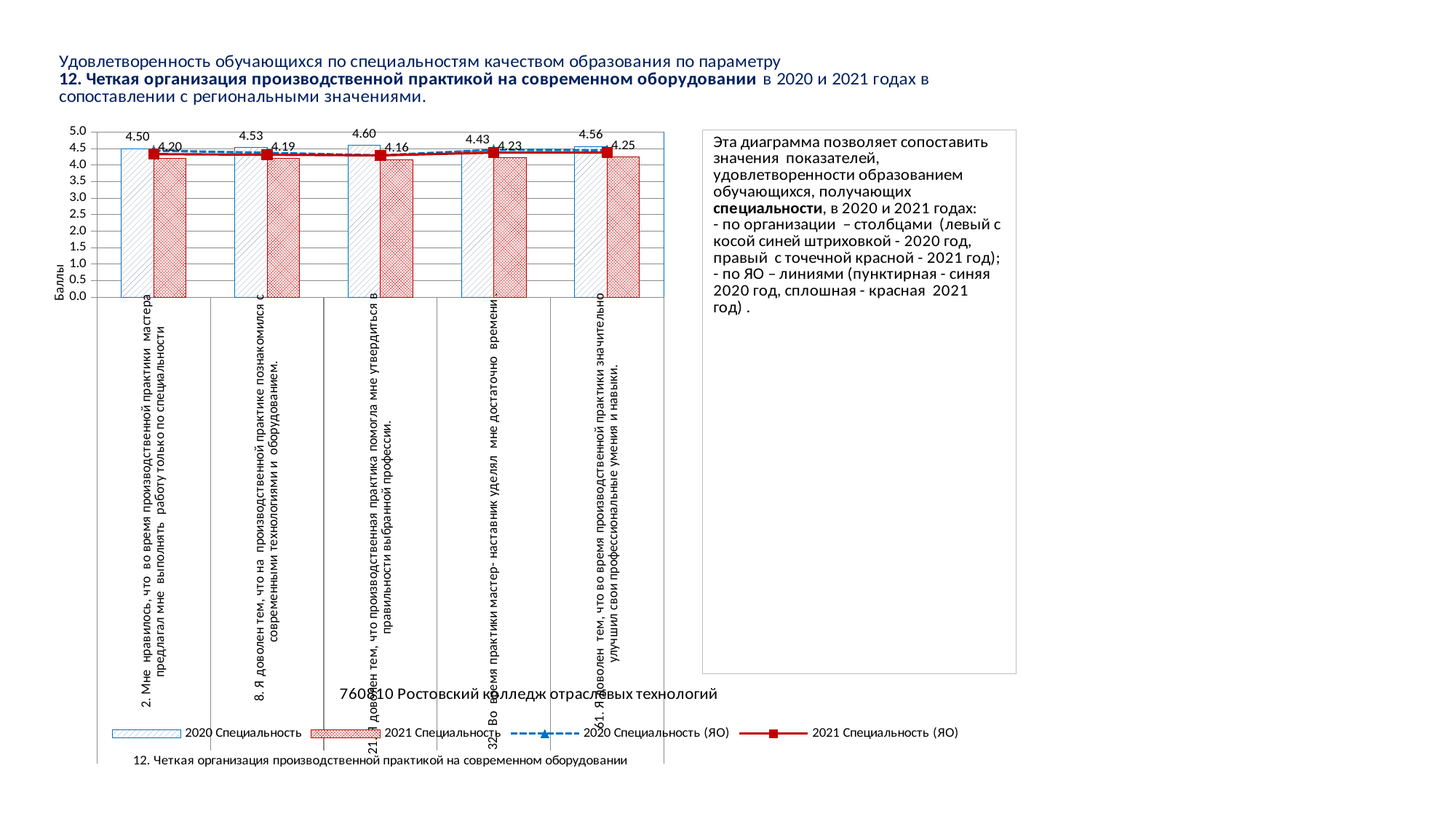
Which category has the highest 2020 Специальность bar? 21. Я доволен тем, что производственная практика помогла мне утвердиться в правильности выбранной профессии. How many categories are shown on the x axis of the chart? 5 What is the difference between the highest and lowest 2020 Специальность bar values? 0.17 What is the value of the 2020 Специальность bar for the category beginning "21. Я доволен тем, что производственная практика помогла мне утвердиться..."? 4.60 Is the 2021 Специальность bar for category 2 greater or less than 4.5? less Which is larger: the 2020 Специальность value for category 8 or for category 32? Category 8 (4.53) Which category has the lowest 2020 Специальность bar? 32. Во время практики мастер-наставник уделял мне достаточно времени What is the value of the 2020 Специальность bar for the category beginning "61. Я доволен тем, что во время производственной практики значительно улучшил..."? 4.56 What is the label of the vertical axis of the chart? Баллы What is the value of the 2020 Специальность bar for the category beginning "2. Мне нравилось, что во время производственной практики мастера..."? 4.50 How many series does the chart legend list? 4 What is the value of the 2020 Специальность bar for the category beginning "32. Во время практики мастер-наставник уделял мне достаточно времени"? 4.43